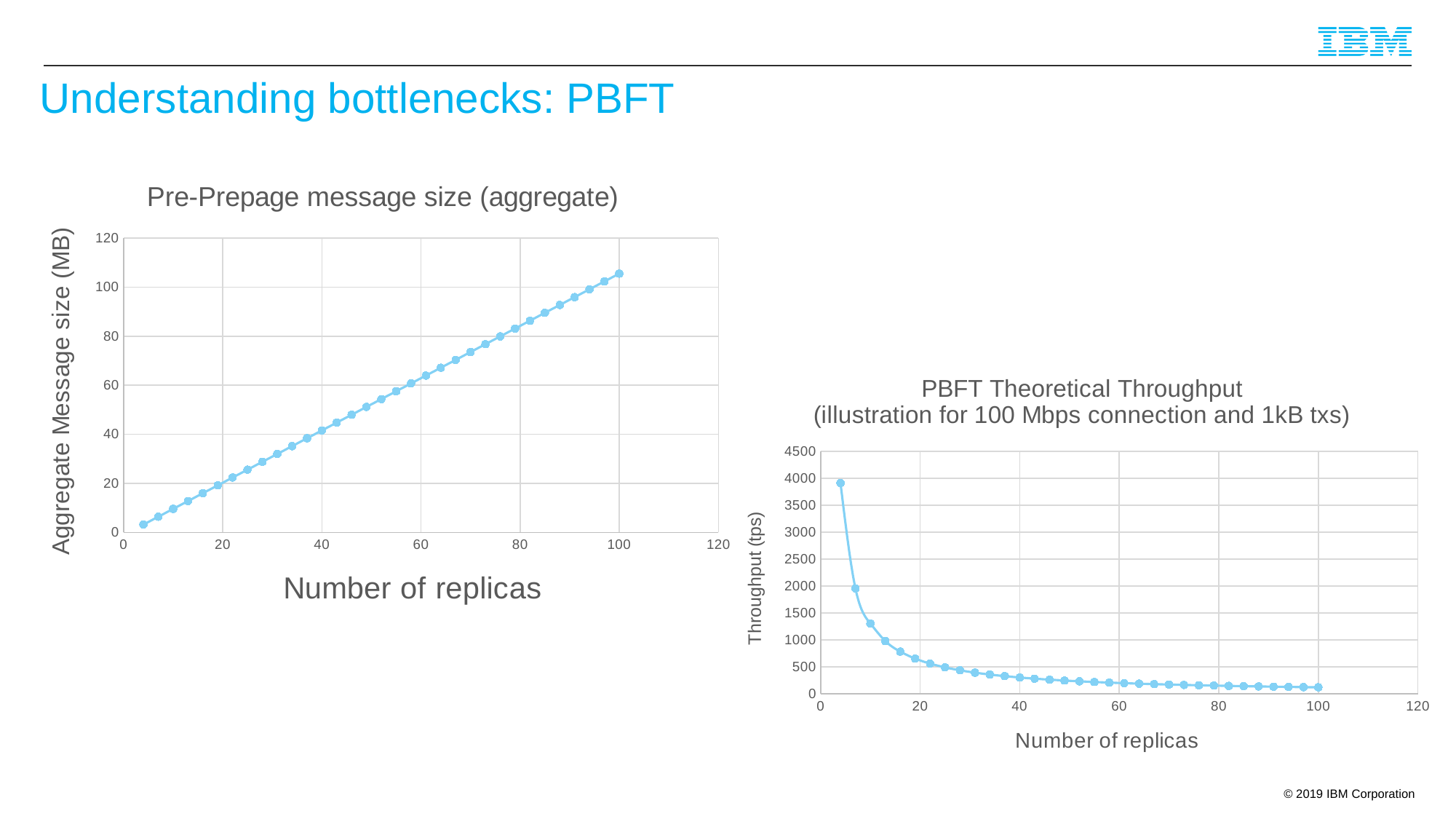
In the 'Pre-Prepage message size (aggregate)' chart, is the aggregate message size at 100 replicas greater or less than 80 MB? greater What is the y-axis label of the 'PBFT Theoretical Throughput' chart? Throughput (tps) What kind of chart is the 'Pre-Prepage message size (aggregate)' chart? line chart In the 'PBFT Theoretical Throughput' chart, is the throughput at the smallest number of replicas greater or less than 3500 tps? greater In the 'Pre-Prepage message size (aggregate)' chart, which is larger: the message size at 40 replicas or at 60 replicas? 60 replicas In the 'PBFT Theoretical Throughput' chart, which is larger: the throughput at 20 replicas or at 80 replicas? 20 replicas In the 'PBFT Theoretical Throughput' chart, does throughput rise or fall as the number of replicas increases? fall What is the x-axis label of the 'Pre-Prepage message size (aggregate)' chart? Number of replicas What kind of chart is the 'PBFT Theoretical Throughput' chart? line chart In the 'PBFT Theoretical Throughput' chart, is the throughput at 100 replicas greater or less than 500 tps? less In the 'Pre-Prepage message size (aggregate)' chart, does the aggregate message size rise or fall as the number of replicas increases? rise